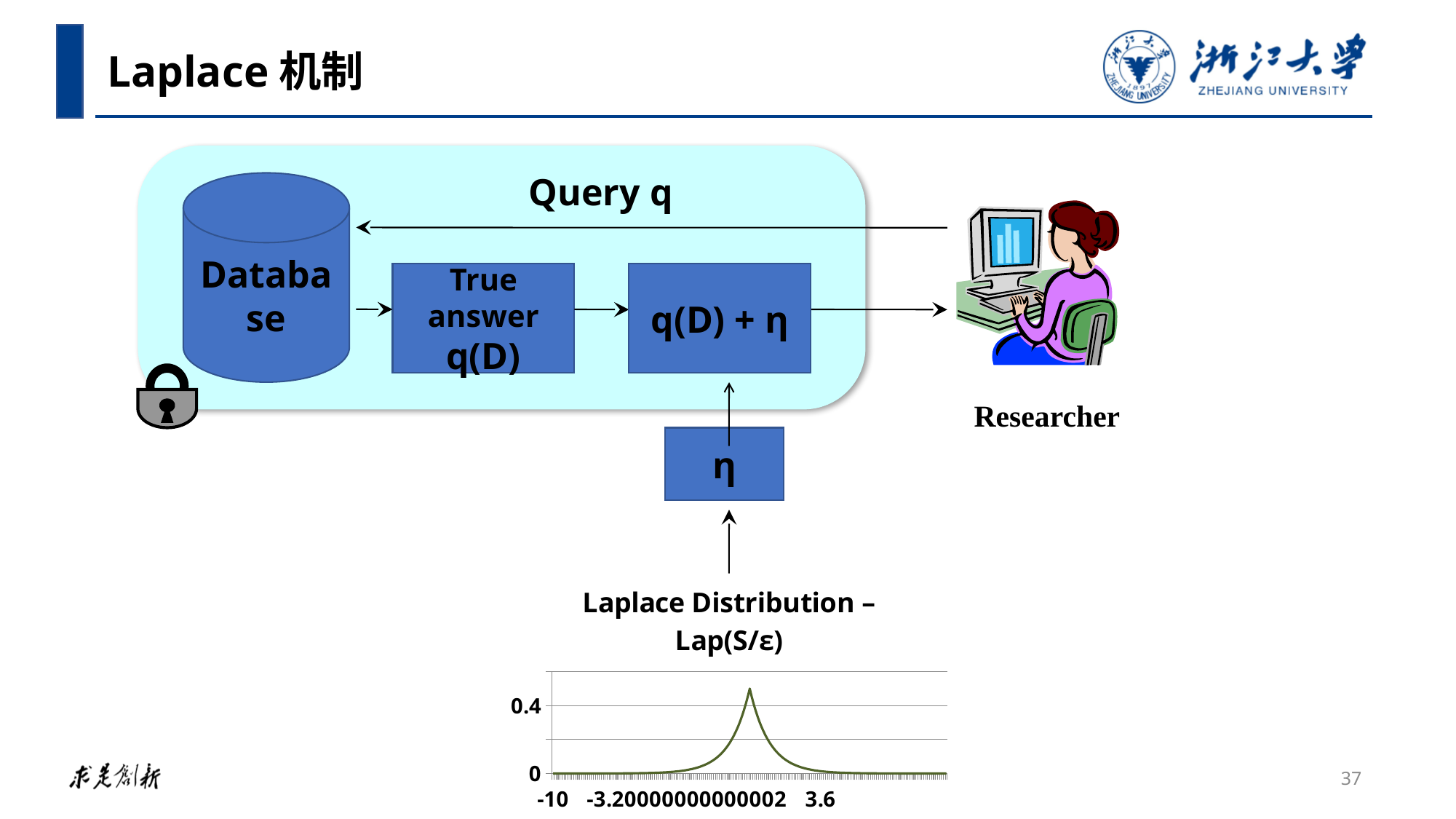
In the Laplace Distribution chart, is the value of the curve at x = -10 greater or less than 0.4? less In the Laplace Distribution chart, is the value of the curve at x = 3.6 greater or less than 0.4? less In the Laplace Distribution chart, is the peak value of the curve greater or less than 0.4? greater In the Laplace Distribution chart, what is the highest value labelled on the vertical axis? 0.4 What kind of chart is shown at the bottom of the slide under the heading "Laplace Distribution – Lap(S/ε)"? line chart In the Laplace Distribution chart, do the values rise or fall as x moves from the centre of the axis toward the right end? fall What is the title printed above the chart at the bottom of the slide? Laplace Distribution – Lap(S/ε) In the Laplace Distribution chart, do the values rise or fall as x moves from -10 toward the centre of the axis? rise